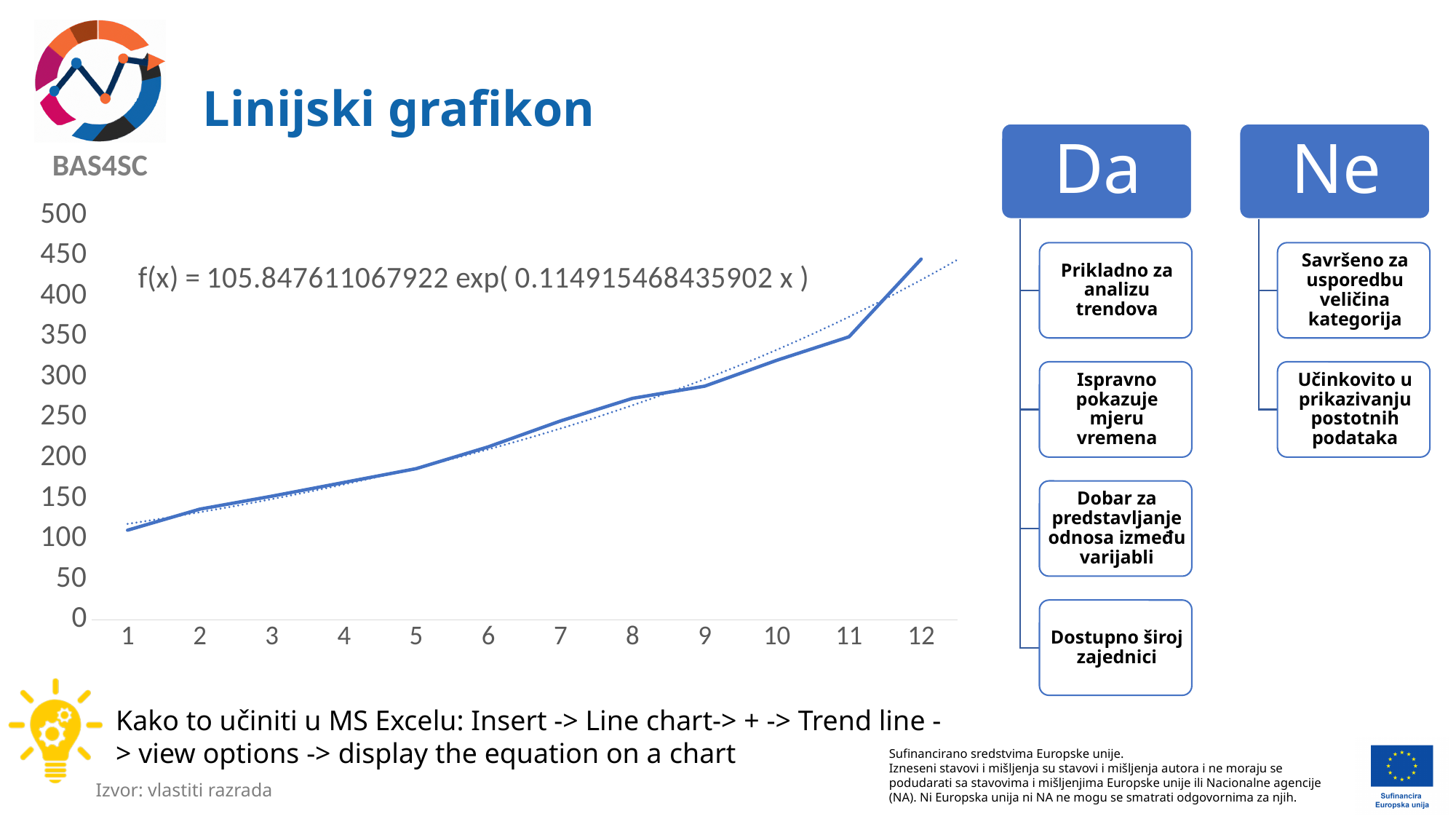
At which x value is the plotted line highest? 12 Which has the larger value, x = 12 or x = 1? 12 Is the value at x = 8 greater or less than 250? greater At which x value is the plotted line lowest? 1 Is the value at x = 11 greater or less than 400? less Do the values in the line chart rise or fall as x increases from 1 to 12? rise Is the value at x = 1 greater or less than 150? less What kind of chart is shown on the slide? line chart What equation is displayed on the chart for the trend line? f(x) = 105.847611067922 exp( 0.114915468435902 x ) How many points are plotted along the x axis of the line chart? 12